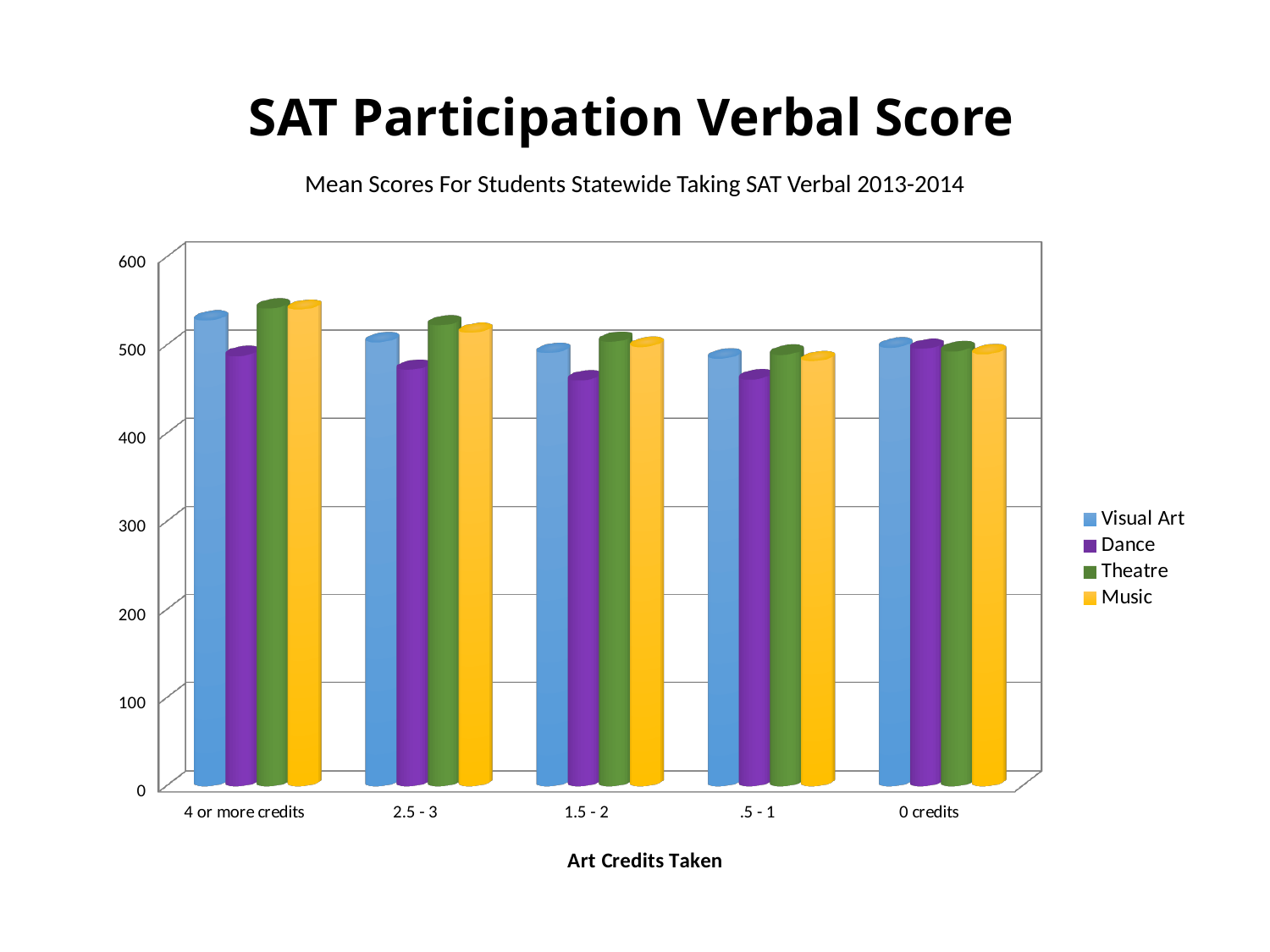
How many art-credit categories are shown on the x axis? 5 Is the value for Dance in the 1.5 - 2 credits category greater or less than 500? less Which colour represents Music in the legend? yellow Is the value for Dance in the 2.5 - 3 credits category greater or less than 500? less Is the value for Theatre in the 4 or more credits category greater or less than 500? greater How many series does the legend list? 4 In the 2.5 - 3 credits category, which is larger, Visual Art or Dance? Visual Art In the 4 or more credits category, which series has the lowest value? Dance In the 4 or more credits category, which is larger, Theatre or Dance? Theatre What kind of chart is shown on the slide? bar chart What is the title of the x axis? Art Credits Taken